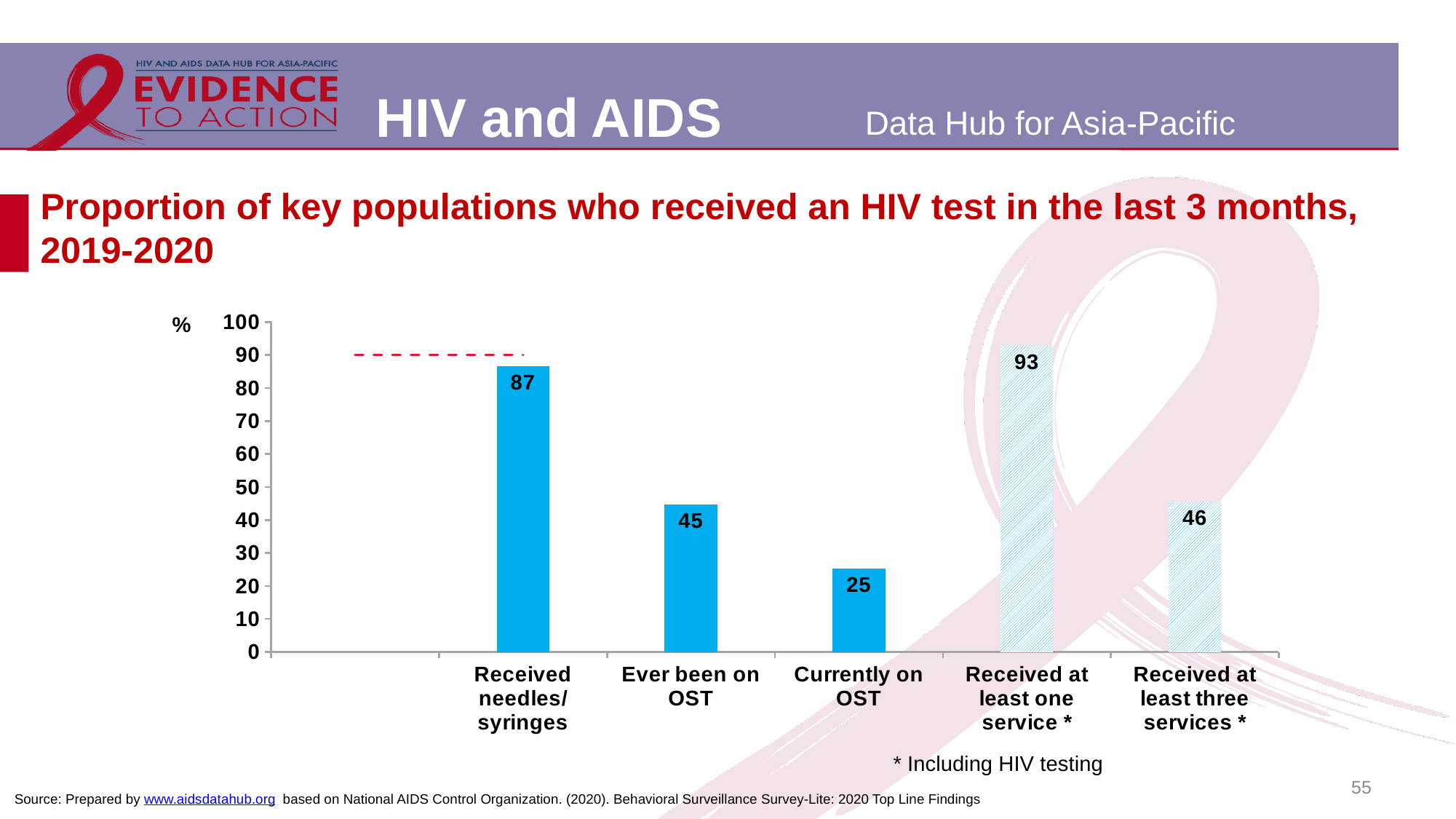
What unit is shown on the y axis of the chart? % What is the value for 'Ever been on OST'? 45 Which category has the lowest value? Currently on OST What is the value for 'Received at least one service *'? 93 What kind of chart is shown on the slide? Bar chart How many labelled bars are shown in the chart? 5 What is the value for 'Currently on OST'? 25 Which category has the highest value? Received at least one service * What is the value for 'Received at least three services *'? 46 What is the value for 'Received needles/ syringes'? 87 Which is larger: 'Received needles/ syringes' or 'Ever been on OST'? Received needles/ syringes What is the difference between 'Received at least one service *' and 'Received at least three services *'? 47